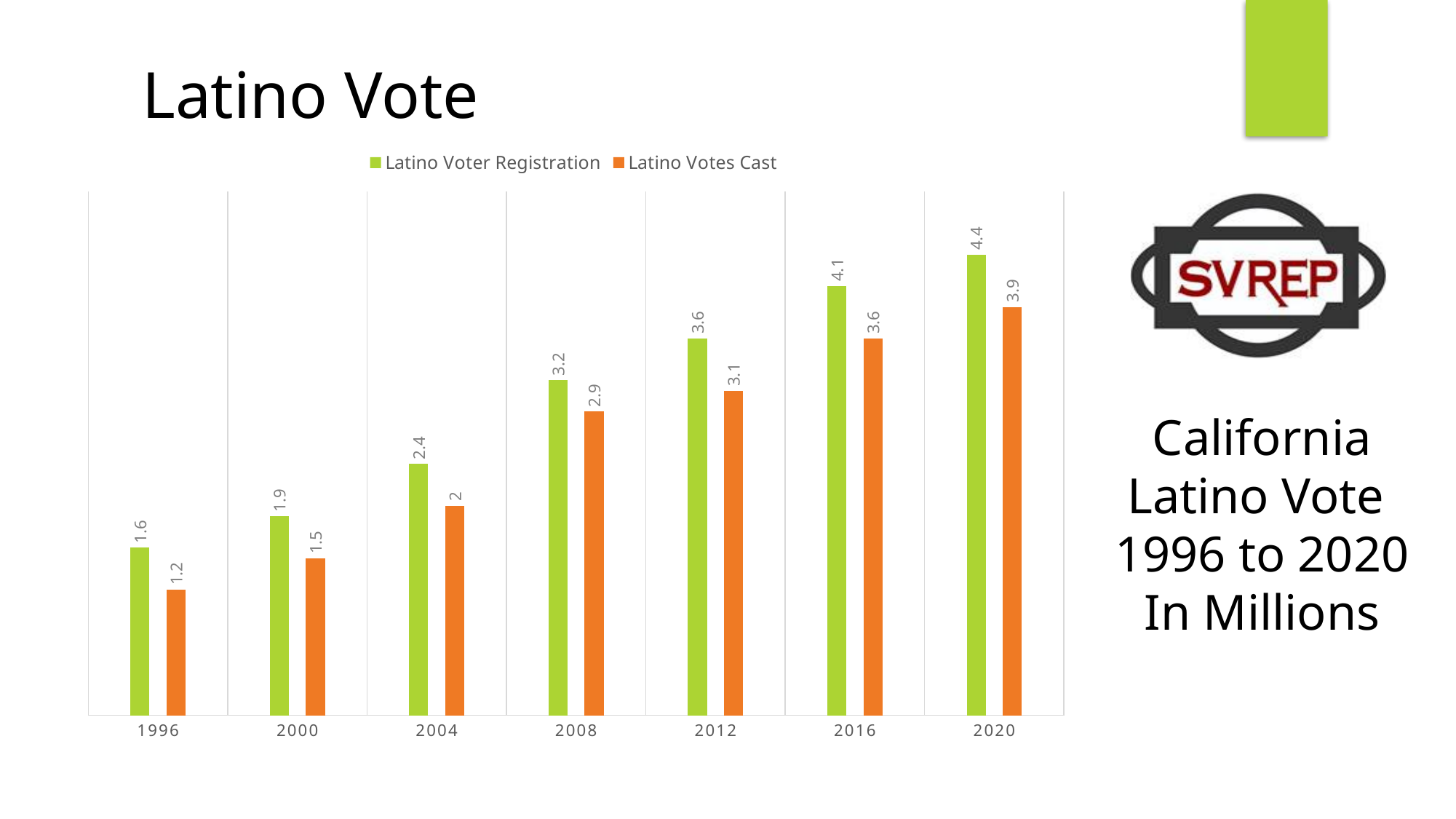
Which is larger: Latino Voter Registration in 2012 or Latino Votes Cast in 2016? They are equal (3.6) What is the Latino Voter Registration value for 2020? 4.4 What is the Latino Votes Cast value for 2004? 2 How many years are shown on the x axis? 7 What is the difference between Latino Votes Cast in 2020 and in 1996? 2.7 How many series does the legend list? 2 Do the Latino Voter Registration values rise or fall from 1996 to 2020? Rise Which year has the lowest Latino Votes Cast value? 1996 Which year has the highest Latino Voter Registration value? 2020 What is the difference between Latino Voter Registration and Latino Votes Cast in 2016? 0.5 What kind of chart is shown on the slide? Bar chart What is the Latino Votes Cast value for 2008? 2.9